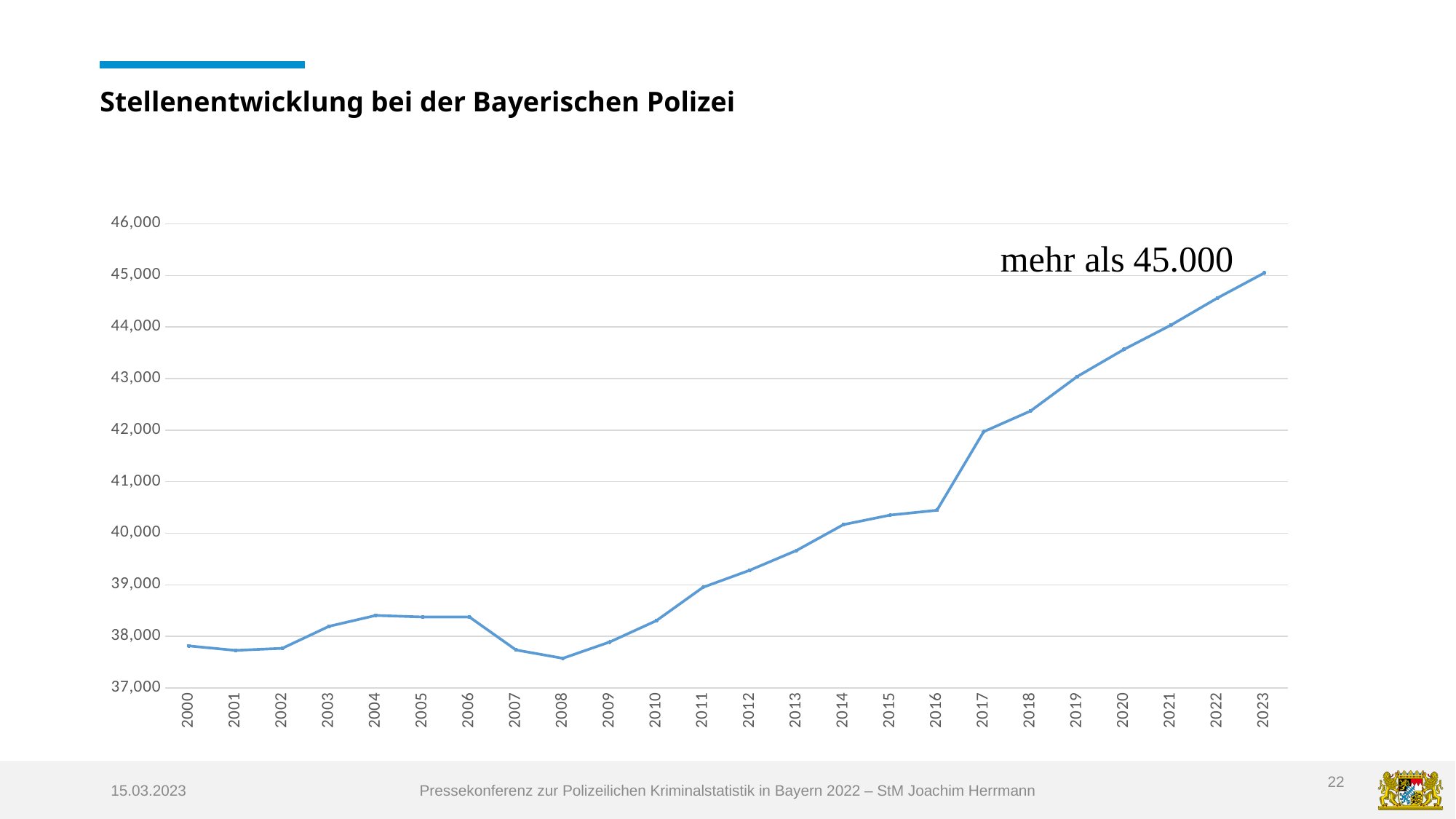
Which year has the highest value? 2023 Which year has the lowest value? 2008 Is the value for 2014 greater or less than 40,000? greater Which year has the larger value, 2004 or 2008? 2004 How many years are plotted along the x axis? 24 What is the title of the slide? Stellenentwicklung bei der Bayerischen Polizei What text annotation is placed near the end of the line? mehr als 45.000 Is the value for 2020 greater or less than 43,000? greater What kind of chart is shown on the slide? line chart Is the value for 2008 greater or less than 38,000? less Overall, do the values rise or fall from 2000 to 2023? rise